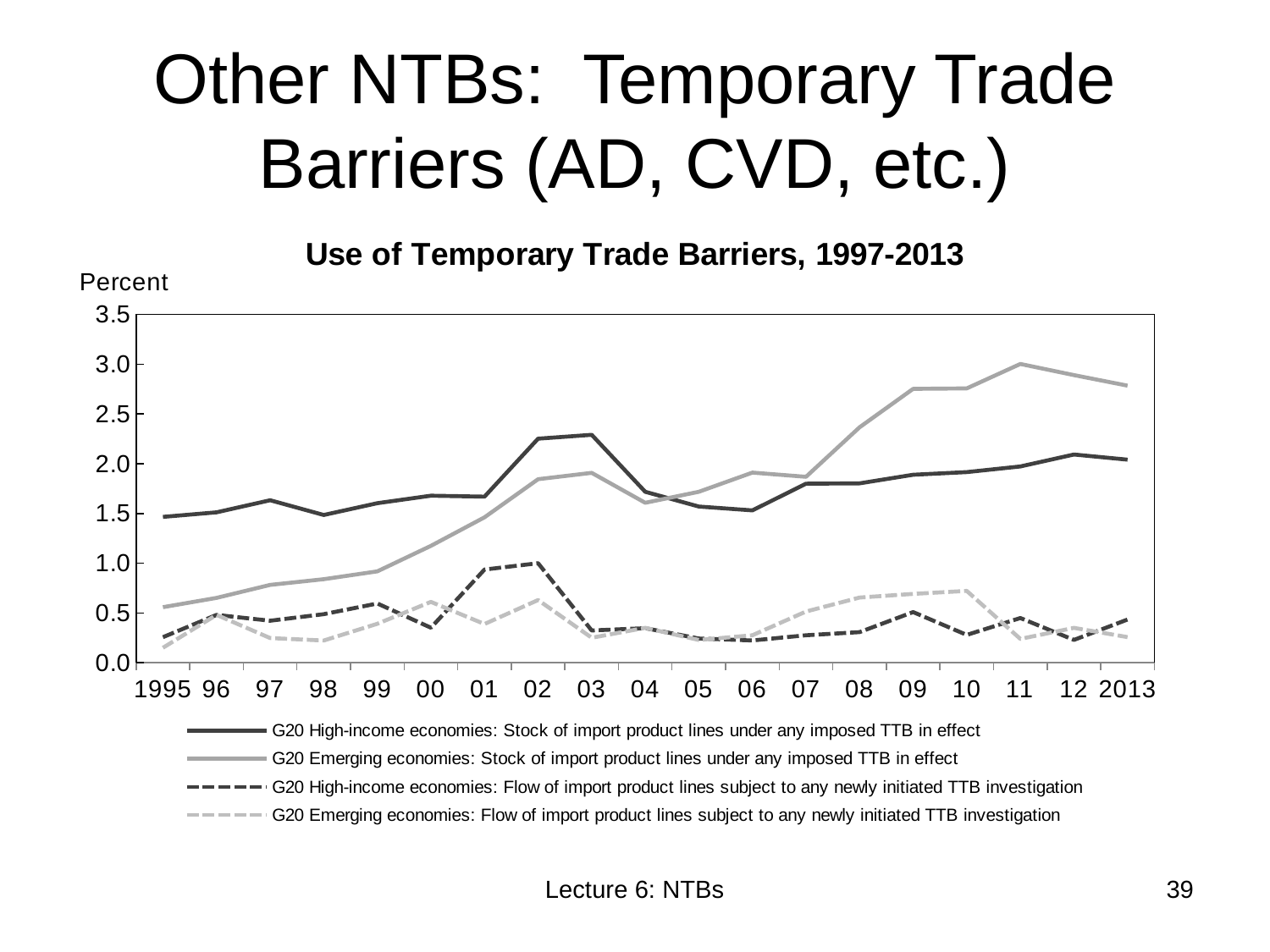
How many years are plotted along the x axis? 19 What is the title of the chart? Use of Temporary Trade Barriers, 1997-2013 Is the value for G20 Emerging economies stock of import product lines under any imposed TTB in 2011 greater or less than 2.5? greater In 2013, which is larger: the stock of import product lines under imposed TTB for G20 Emerging economies or for G20 High-income economies? G20 Emerging economies Is the value for G20 High-income economies flow of import product lines subject to newly initiated TTB investigation in 2002 greater or less than 0.5? greater What label is shown on the vertical axis? Percent In which year does the G20 Emerging economies stock of import product lines under any imposed TTB reach its highest value? 2011 What kind of chart is shown on the slide? Line chart Is the value for G20 Emerging economies stock of import product lines under any imposed TTB in 1995 greater or less than 1.0? less How many series does the legend list? 4 Which series reaches the highest value anywhere on the chart? G20 Emerging economies: Stock of import product lines under any imposed TTB in effect Does the G20 Emerging economies stock of import product lines under any imposed TTB rise or fall overall from 1995 to 2013? Rise